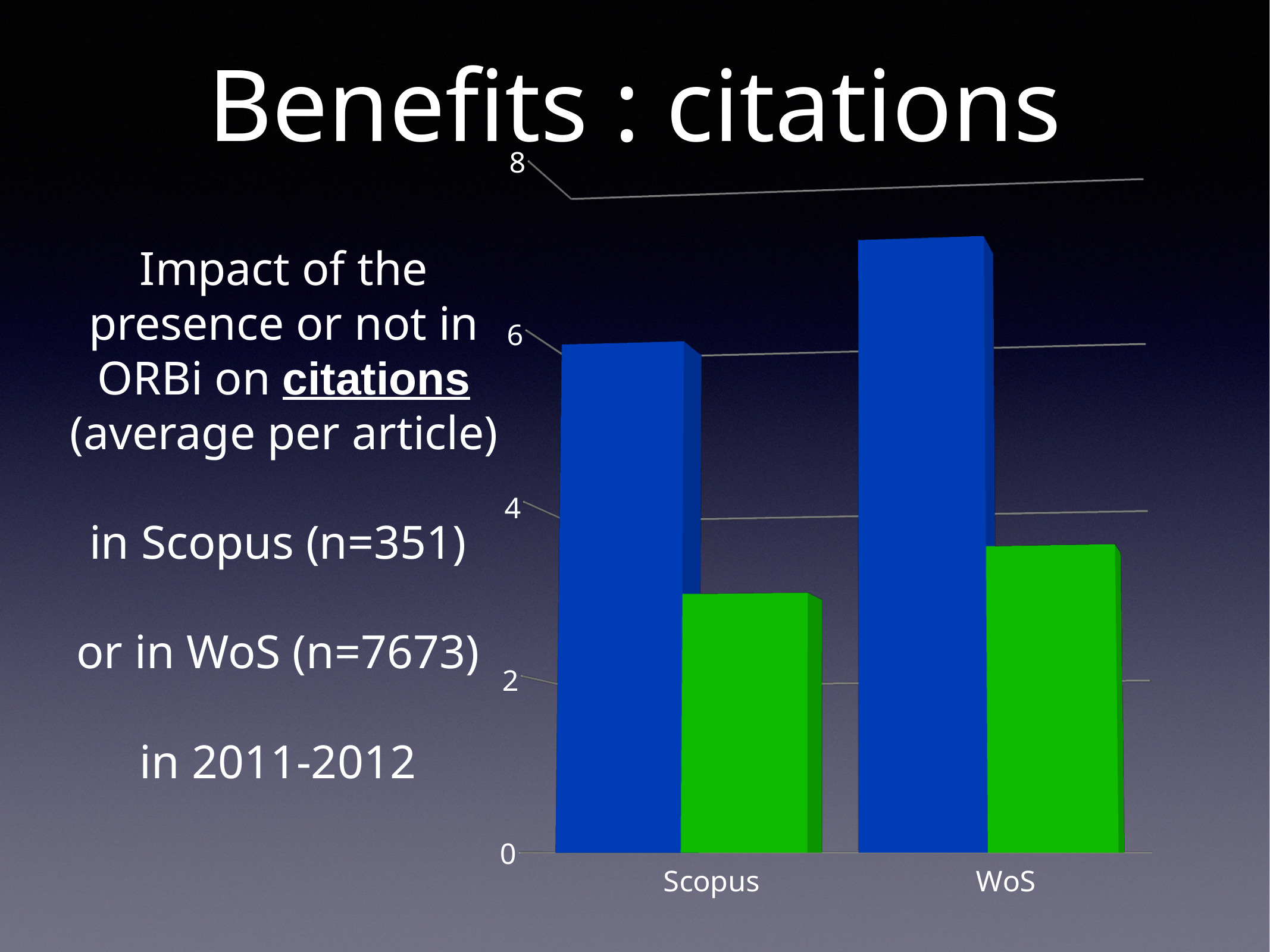
Which category has the tallest bar in the chart? WoS Is the blue bar for WoS greater or less than 6? greater What is the title of the slide containing the chart? Benefits : citations Is the green bar for WoS greater or less than 4? less Which is larger, the green bar for Scopus or the green bar for WoS? the green bar for WoS What is the highest value shown on the vertical axis of the chart? 8 Which is larger, the blue bar for Scopus or the blue bar for WoS? the blue bar for WoS How many categories are shown on the x axis of the chart? 2 Which bar is the lowest in the chart? the green bar for Scopus What kind of chart is shown on the slide? bar chart Is the green bar for Scopus greater or less than 4? less